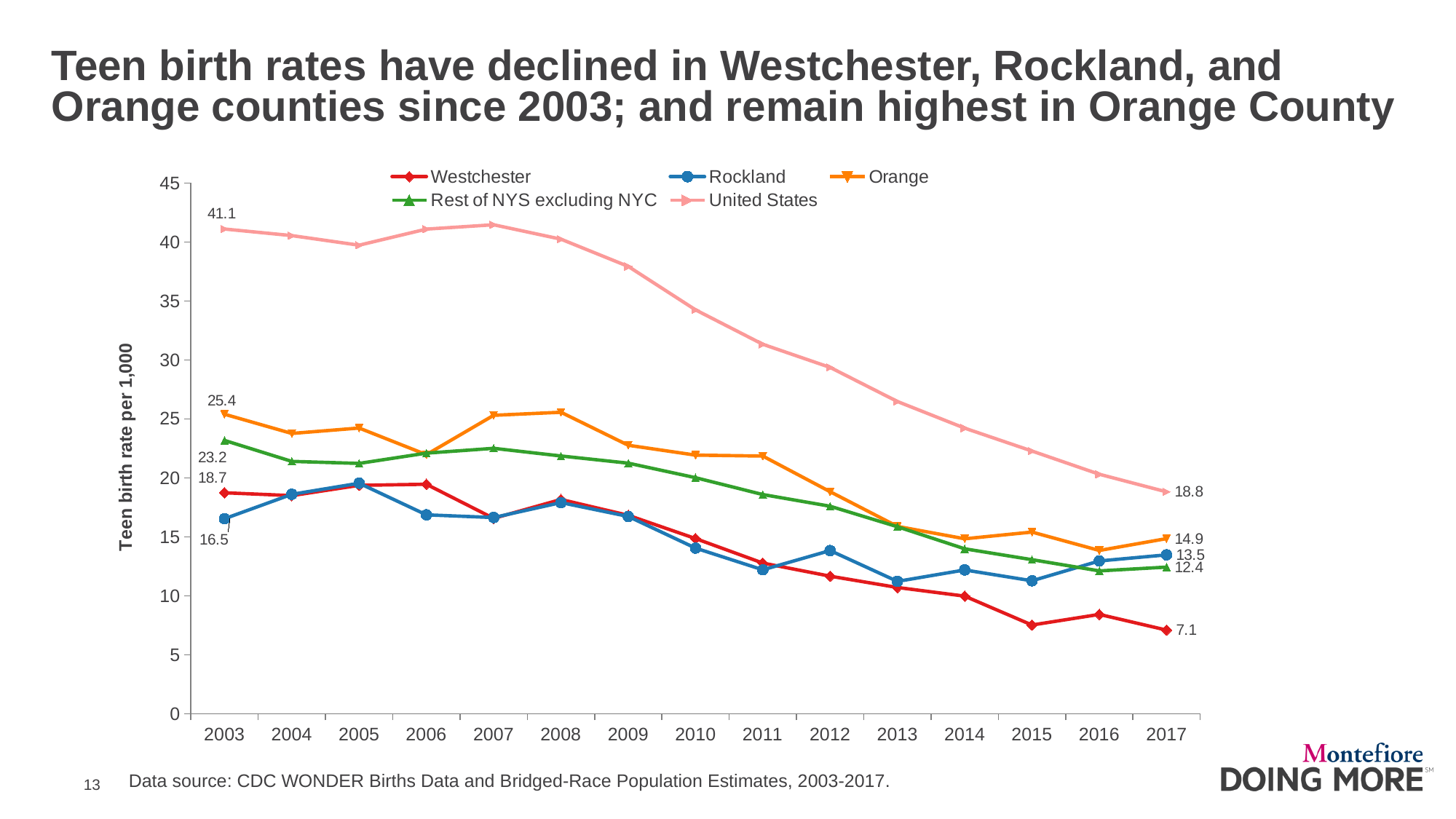
Which series had the highest teen birth rate in 2017? United States What was the teen birth rate for Orange in 2003? 25.4 What was the teen birth rate for the United States in 2003? 41.1 What type of chart is shown on the slide? line chart How many years are shown on the x axis? 15 Which series had the lowest teen birth rate in 2017? Westchester Is the value for the United States in 2010 greater or less than 30? greater What was the teen birth rate for Rockland in 2017? 13.5 How many series does the legend list? 5 What was the teen birth rate for Westchester in 2017? 7.1 By how much did the United States teen birth rate fall from 2003 to 2017? 22.3 In 2017, which had a higher teen birth rate, Orange or Rest of NYS excluding NYC? Orange